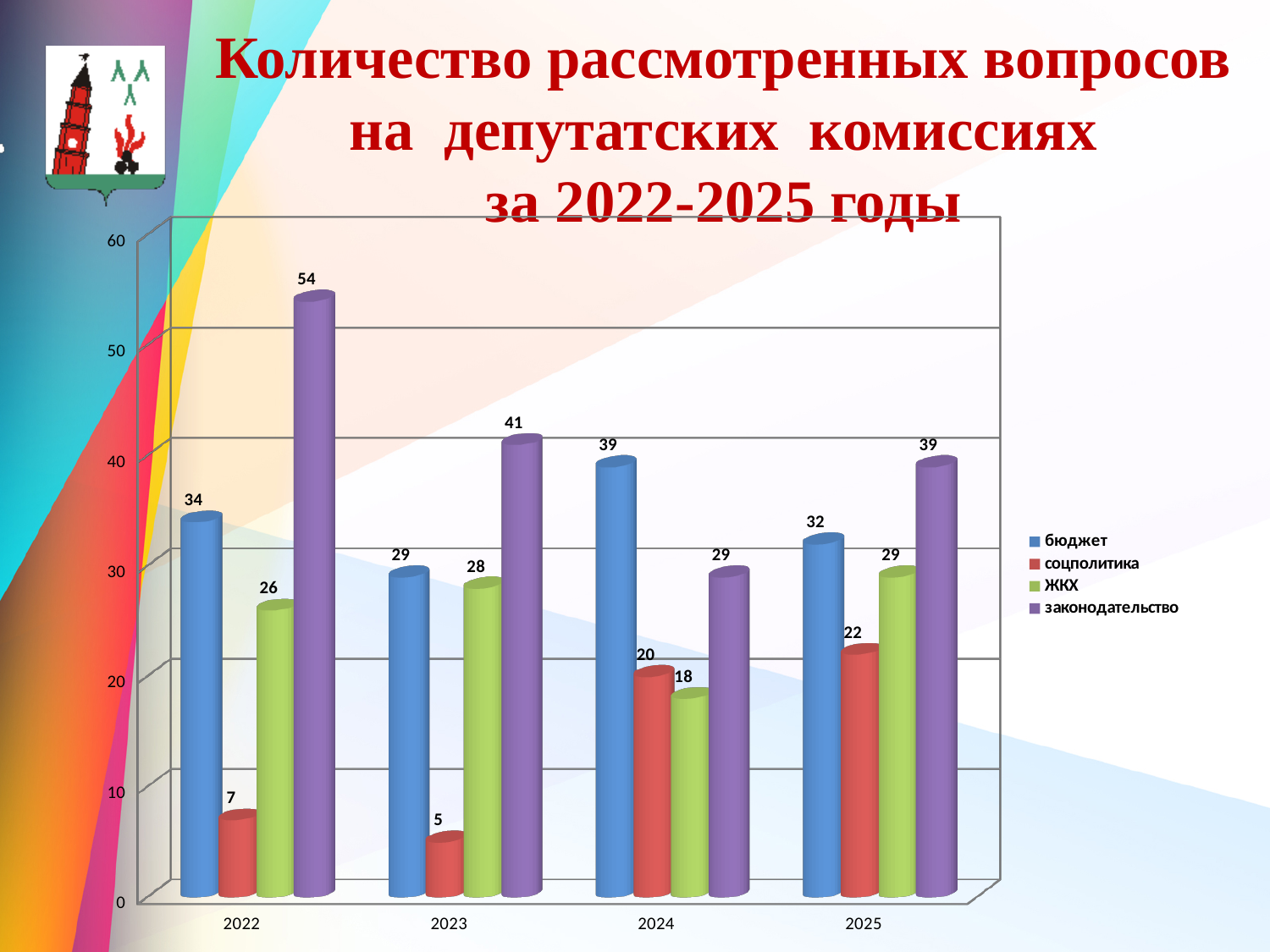
What is the value for ЖКХ in 2025? 29 In which year is the value for законодательство the highest? 2022 How many years are shown on the x axis? 4 What is the value for соцполитика in 2024? 20 In which year is the value for соцполитика the lowest? 2023 Which colour represents ЖКХ in the legend? green How many series does the legend list? 4 Which is larger in 2024: бюджет or законодательство? бюджет What is the value for бюджет in 2022? 34 What kind of chart is shown on the slide? bar chart What is the difference between законодательство and бюджет in 2022? 20 What is the value for законодательство in 2023? 41